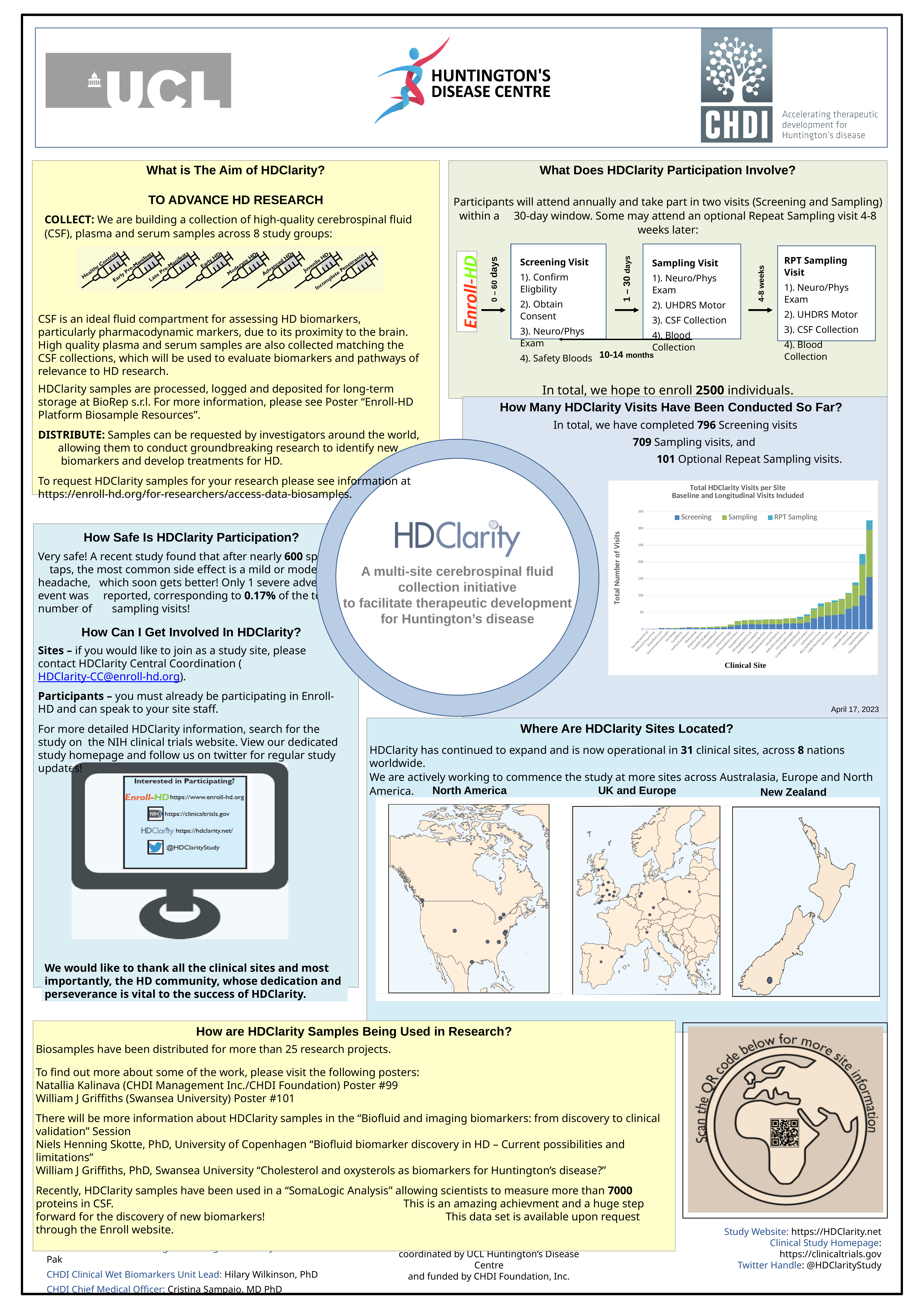
In the 'Total HDClarity Visits per Site' chart, do the bar heights rise or fall from left to right along the x axis? rise In the 'Total HDClarity Visits per Site' chart, is the total for the tallest bar greater or less than 350? less What is the label of the y axis in the 'Total HDClarity Visits per Site' chart? Total Number of Visits Which series are listed in the legend of the 'Total HDClarity Visits per Site' chart? Screening, Sampling, RPT Sampling How many series does the legend of the 'Total HDClarity Visits per Site' chart list? 3 What kind of chart is 'Total HDClarity Visits per Site'? stacked bar chart In the 'Total HDClarity Visits per Site' chart, is the total for the tallest bar greater or less than 300? greater